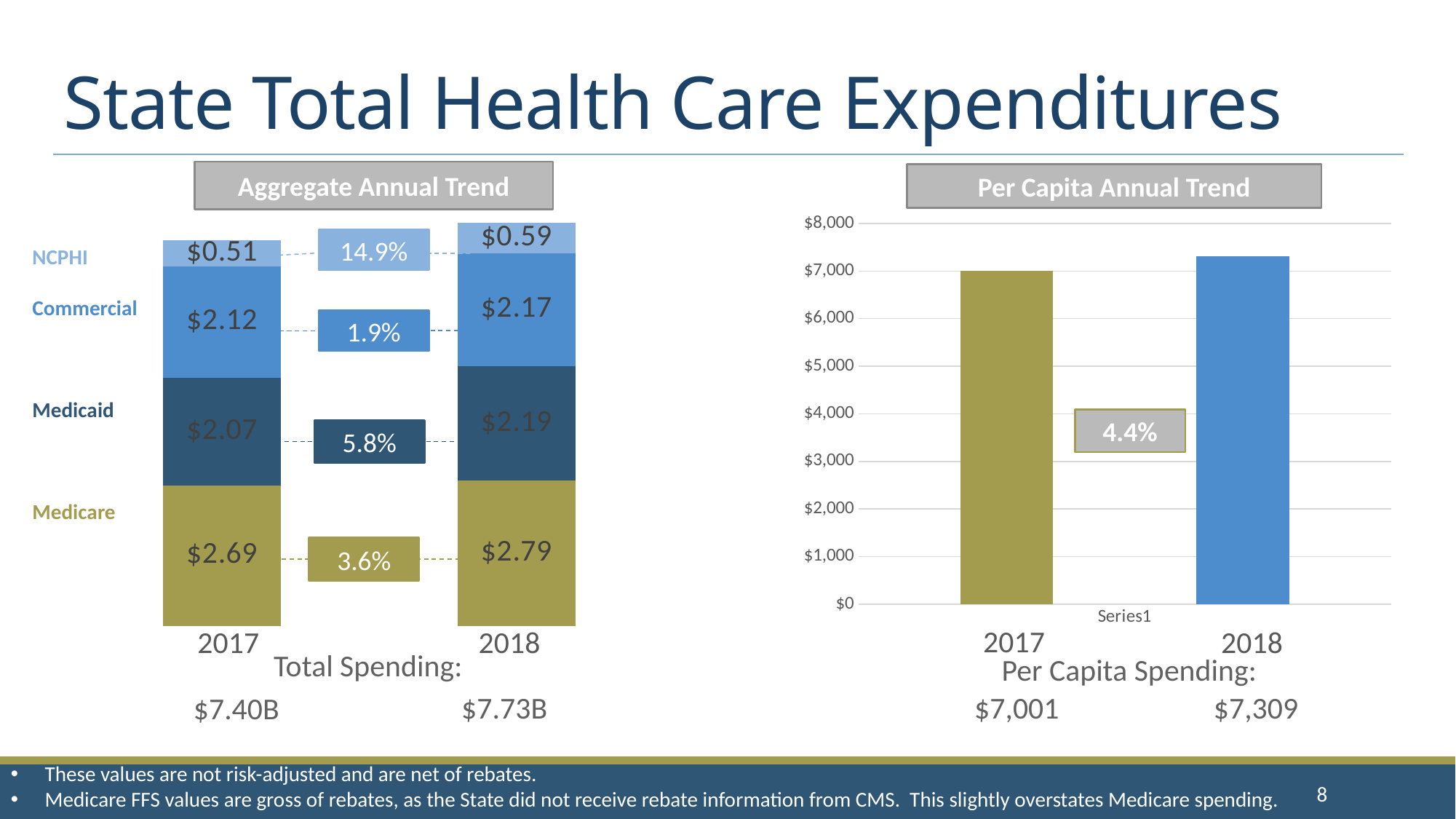
In the Per Capita Annual Trend chart, what is the per capita spending for 2017? $7,001 In the Aggregate Annual Trend chart, what percentage growth is shown for NCPHI? 14.9% In the Aggregate Annual Trend chart, which segment is the smallest in the 2017 bar? NCPHI In the Per Capita Annual Trend chart, is the value for 2018 greater or less than $7,000? greater In the Aggregate Annual Trend chart, what is the difference between the Medicaid values for 2018 and 2017? $0.12 In the Aggregate Annual Trend chart, which segment is the largest in the 2018 bar? Medicare In the Aggregate Annual Trend chart, what is the Medicare value for 2017? $2.69 In the Aggregate Annual Trend chart, what is the total spending shown for 2018? $7.73B In the Aggregate Annual Trend chart, what is the NCPHI value for 2018? $0.59 What kind of chart is the Per Capita Annual Trend chart? bar chart In the Aggregate Annual Trend chart, what is the Commercial value for 2018? $2.17 In the Aggregate Annual Trend chart, how many segments make up each stacked bar? 4